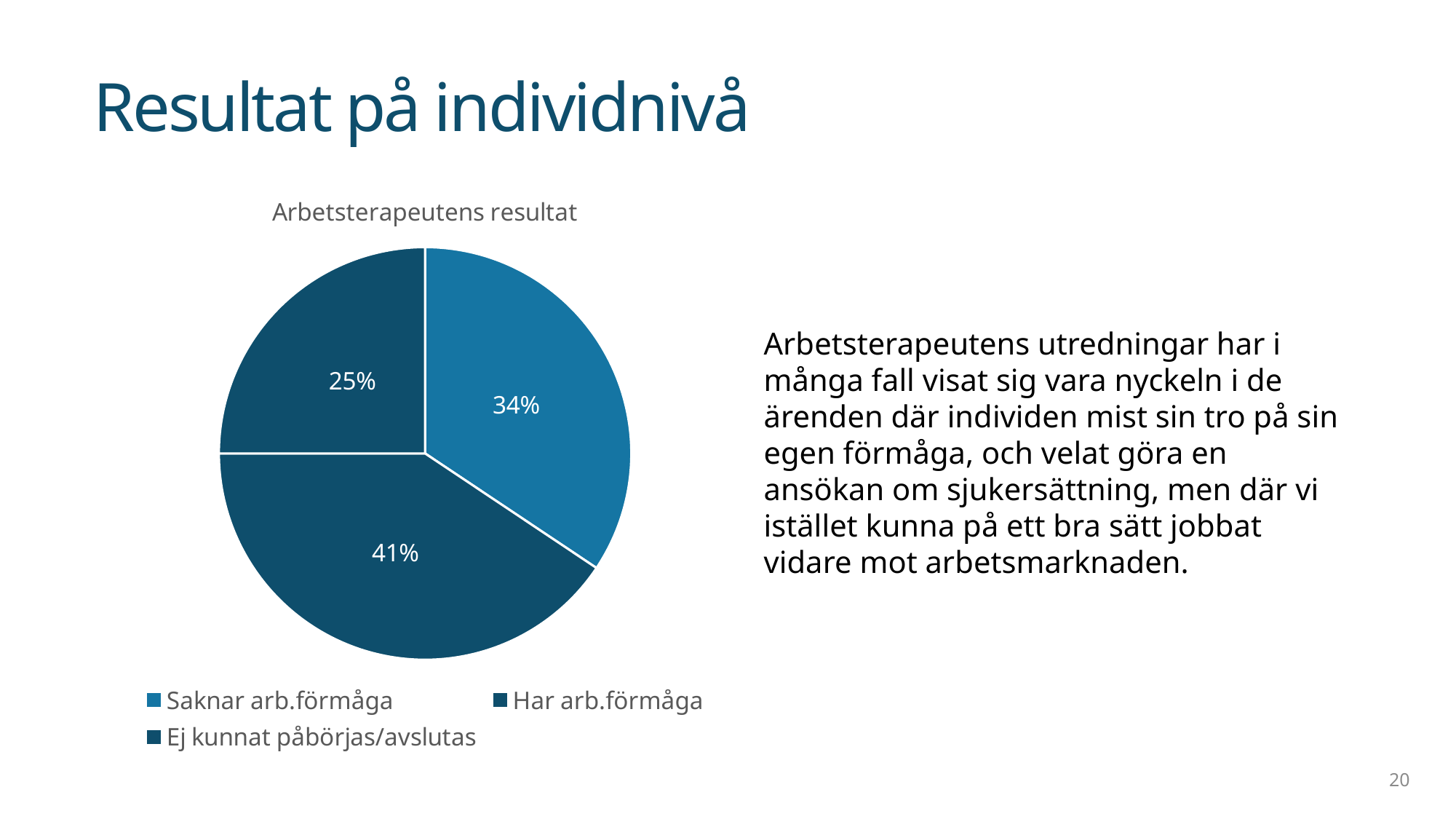
Which category has the largest share of the pie? Har arb.förmåga Which category has the smallest share of the pie? Ej kunnat påbörjas/avslutas What is the difference in percentage points between 'Har arb.förmåga' and 'Saknar arb.förmåga'? 7 What percentage of the pie is 'Ej kunnat påbörjas/avslutas'? 25% What type of chart is shown on the slide? pie chart What is the title of the chart? Arbetsterapeutens resultat Which is larger: the share for 'Saknar arb.förmåga' or for 'Ej kunnat påbörjas/avslutas'? Saknar arb.förmåga What percentage of the pie is 'Har arb.förmåga'? 41% How many entries does the legend list? 3 What is the difference in percentage points between 'Saknar arb.förmåga' and 'Ej kunnat påbörjas/avslutas'? 9 How many slices does the pie chart have? 3 What percentage of the pie is 'Saknar arb.förmåga'? 34%